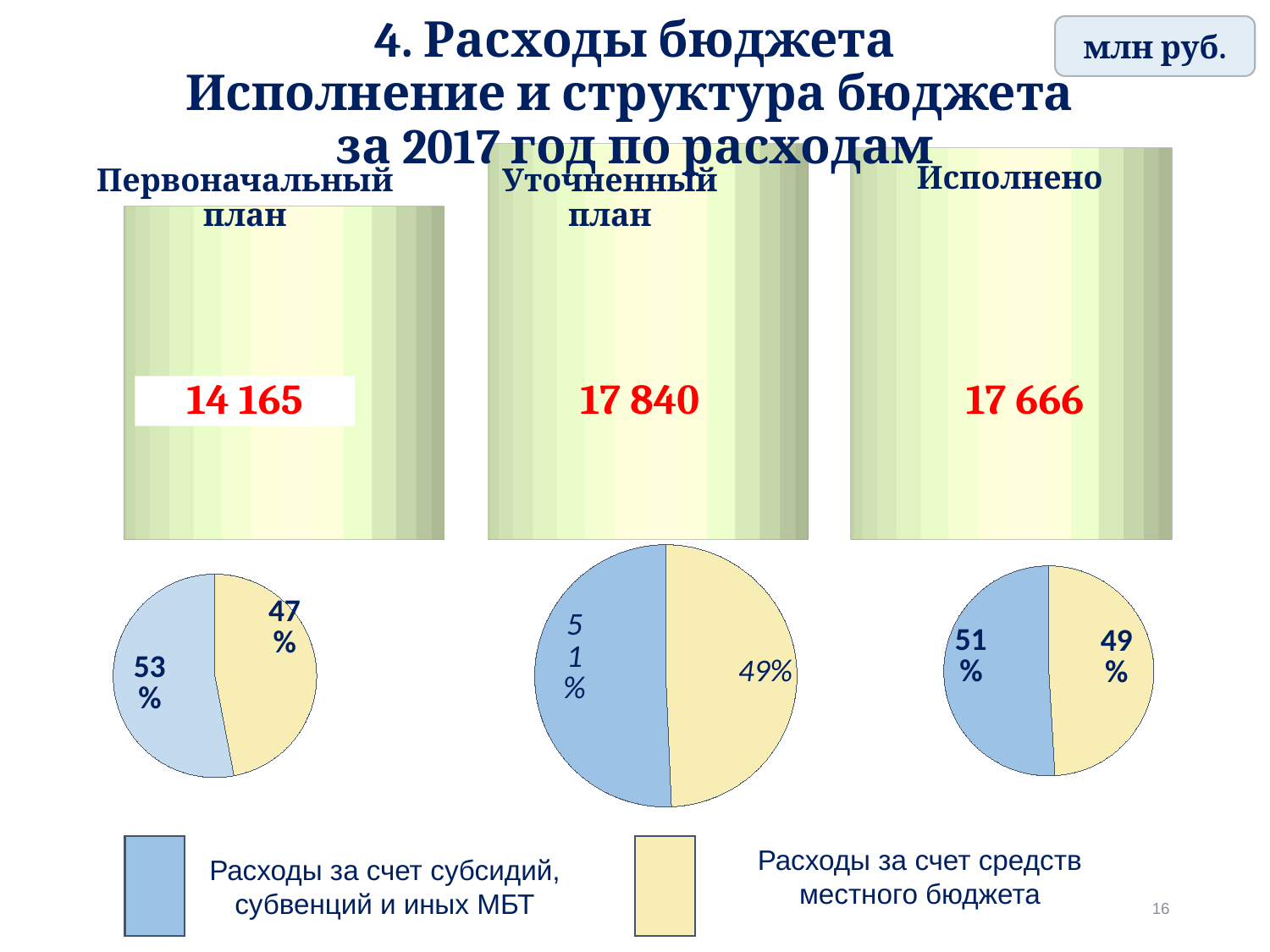
In the bar chart, what is the difference between Уточненный план and Первоначальный план? 3 675 In the pie chart under Первоначальный план, what share is Расходы за счет субсидий, субвенций и иных МБТ? 53% In the bar chart, what is the difference between Уточненный план and Исполнено? 174 In the bar chart, which category has the highest value? Уточненный план In the bar chart, what is the value for Уточненный план? 17 840 In the bar chart, which category has the lowest value? Первоначальный план In the bar chart, what is the value for Первоначальный план? 14 165 In the pie chart under Уточненный план, what share is Расходы за счет средств местного бюджета? 49% How many bars are shown in the bar chart? 3 In the bar chart, what is the value for Исполнено? 17 666 What unit is shown in the box at the top right of the slide? млн руб. In the pie chart under Исполнено, what share is Расходы за счет субсидий, субвенций и иных МБТ? 51%